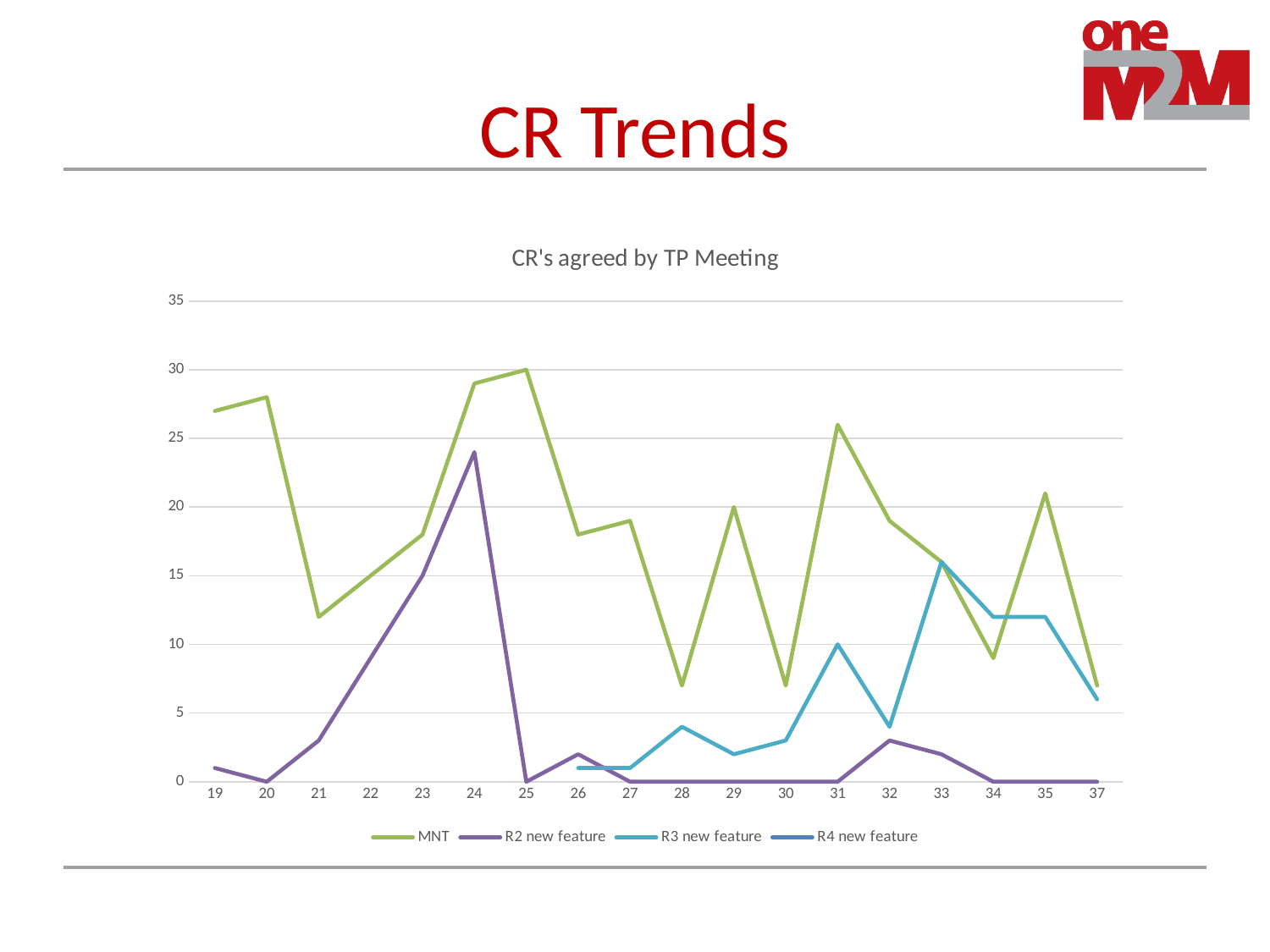
At TP meeting 31, which series has the larger value, MNT or R3 new feature? MNT How many series does the legend list? 4 What is the R2 new feature value at TP meeting 25? 0 What kind of chart is shown on the slide? line chart How many TP meeting numbers are shown on the x axis? 18 What is the MNT value at TP meeting 25? 30 At which TP meeting does the R2 new feature series reach its highest value? 24 What is the MNT value at TP meeting 29? 20 What is the title of the chart? CR's agreed by TP Meeting Is the R2 new feature value at TP meeting 24 greater or less than 20? greater Is the MNT value at TP meeting 28 greater or less than 10? less What is the R3 new feature value at TP meeting 31? 10